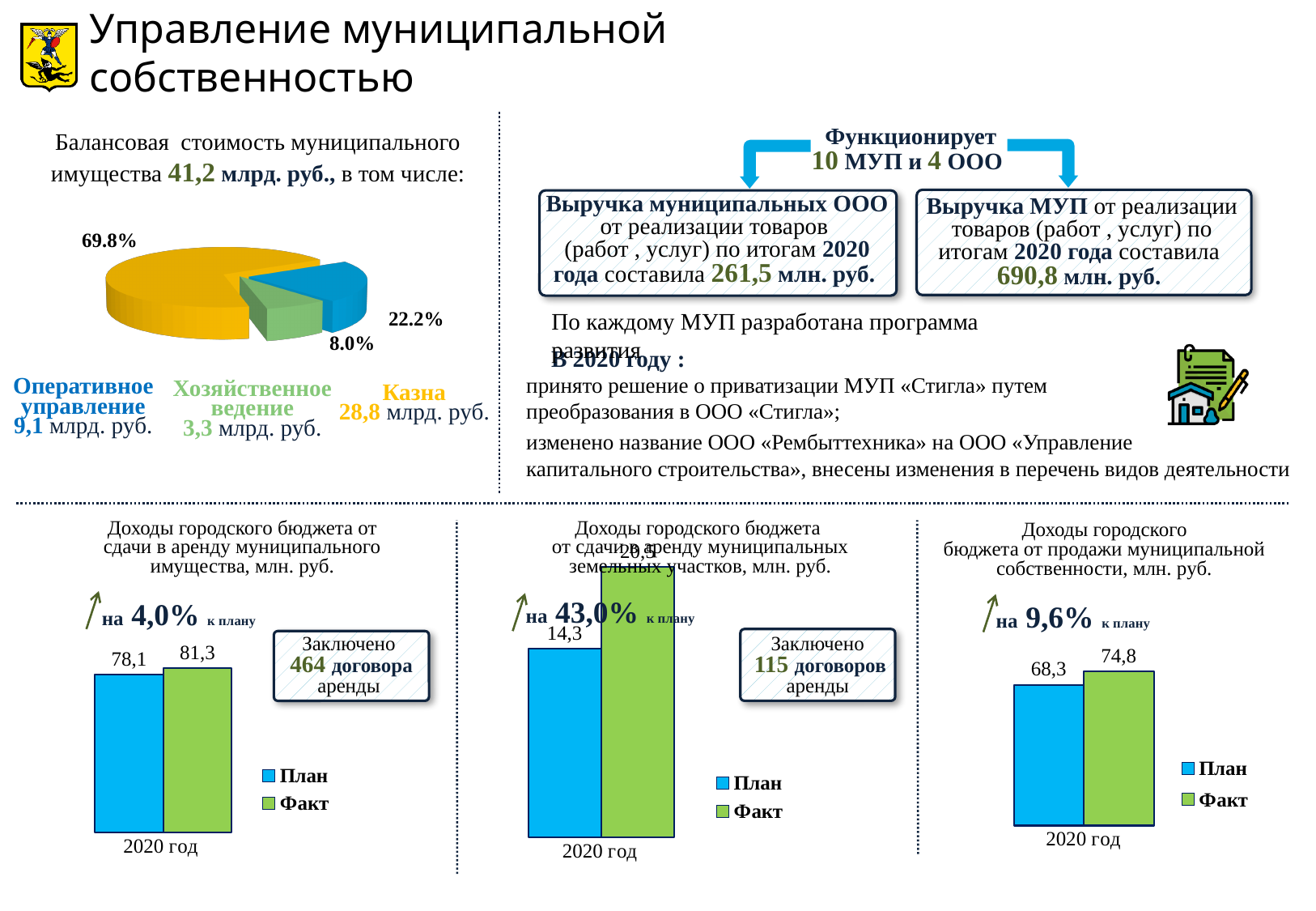
How many slices does the pie chart on the top left have? 3 In the bottom-right chart (Доходы городского бюджета от продажи муниципальной собственности), what is the value for Факт? 74,8 What kind of chart is shown on the top left of the slide? Pie chart In the pie chart on the top left, which category has the smallest slice? Хозяйственное ведение In the bottom-left chart (Доходы городского бюджета от сдачи в аренду муниципального имущества), what is the value for План? 78,1 In the bottom-right chart (Доходы городского бюджета от продажи муниципальной собственности), how many series does the legend list? 2 In the pie chart on the top left, what share is labelled for the blue slice (Оперативное управление)? 22.2% In the bottom-left chart (Доходы городского бюджета от сдачи в аренду муниципального имущества), what is the difference between Факт and План? 3,2 In the bottom-middle chart (Доходы городского бюджета от сдачи в аренду муниципальных земельных участков), which is larger, План or Факт? Факт In the pie chart on the top left, what share does the largest slice (Казна) have? 69.8% In the bottom-middle chart (Доходы городского бюджета от сдачи в аренду муниципальных земельных участков), what is the value for План? 14,3 In the bottom-left chart (Доходы городского бюджета от сдачи в аренду муниципального имущества), what is the value for Факт? 81,3